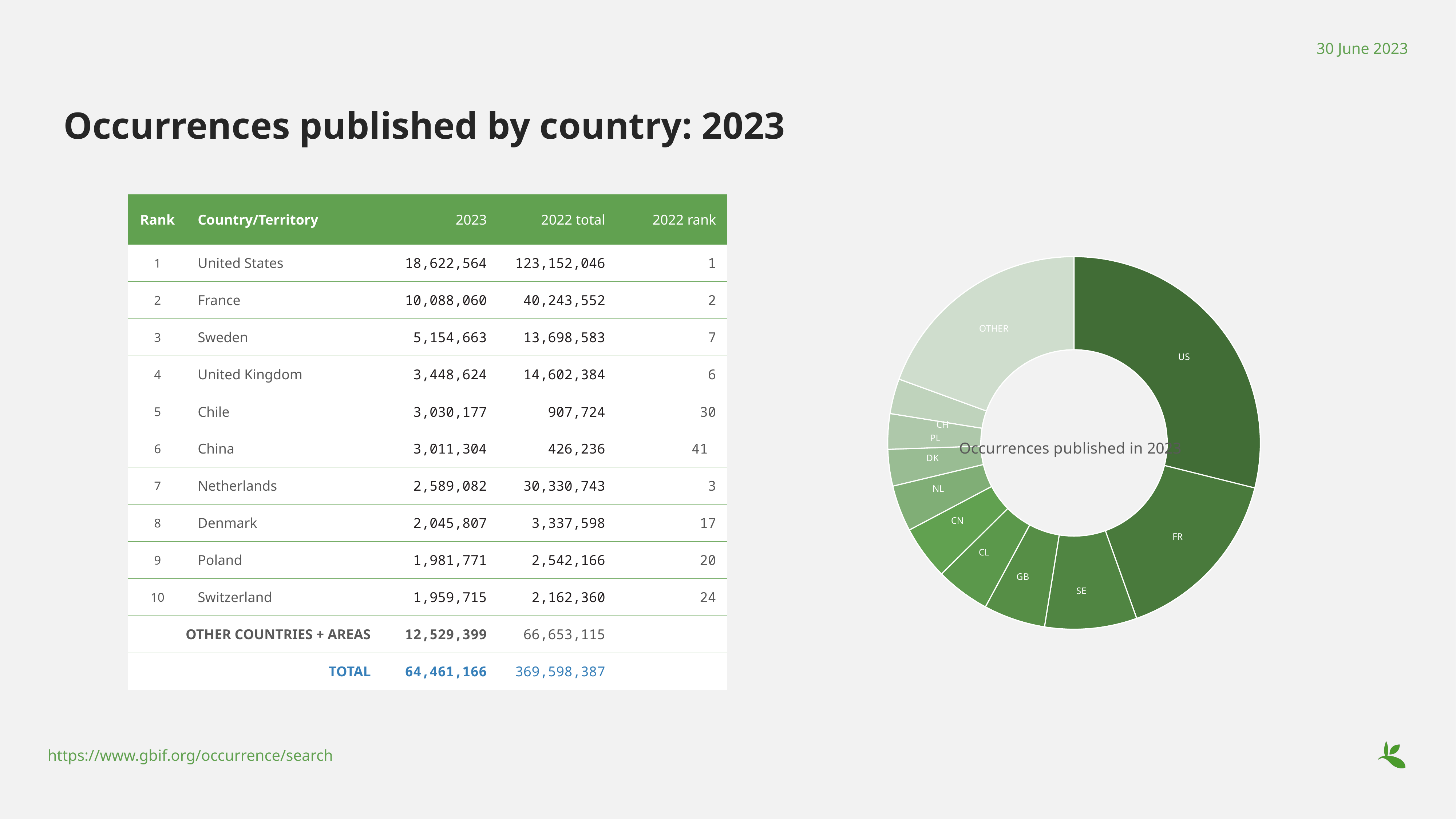
What is the difference between the US and FR values for 2023 shown in the table? 8,534,504 In the donut chart, which slice is larger, US or OTHER? US What is the total number of occurrences published in 2023 across all slices of the donut chart, as given in the table? 64,461,166 What is the number of occurrences published in 2023 for the OTHER slice, as given in the table? 12,529,399 What kind of chart is shown on the right of the slide? Donut (pie) chart What is the number of occurrences published in 2023 for the FR slice, as given in the table? 10,088,060 What text is written in the centre of the donut chart? Occurrences published in 2023 In the donut chart, which slice is larger, GB or NL? GB What is the number of occurrences published in 2023 for the US slice, as given in the table? 18,622,564 In the donut chart, which slice is larger, FR or SE? FR How many slices does the donut chart have? 11 Which slice of the donut chart is the largest? US